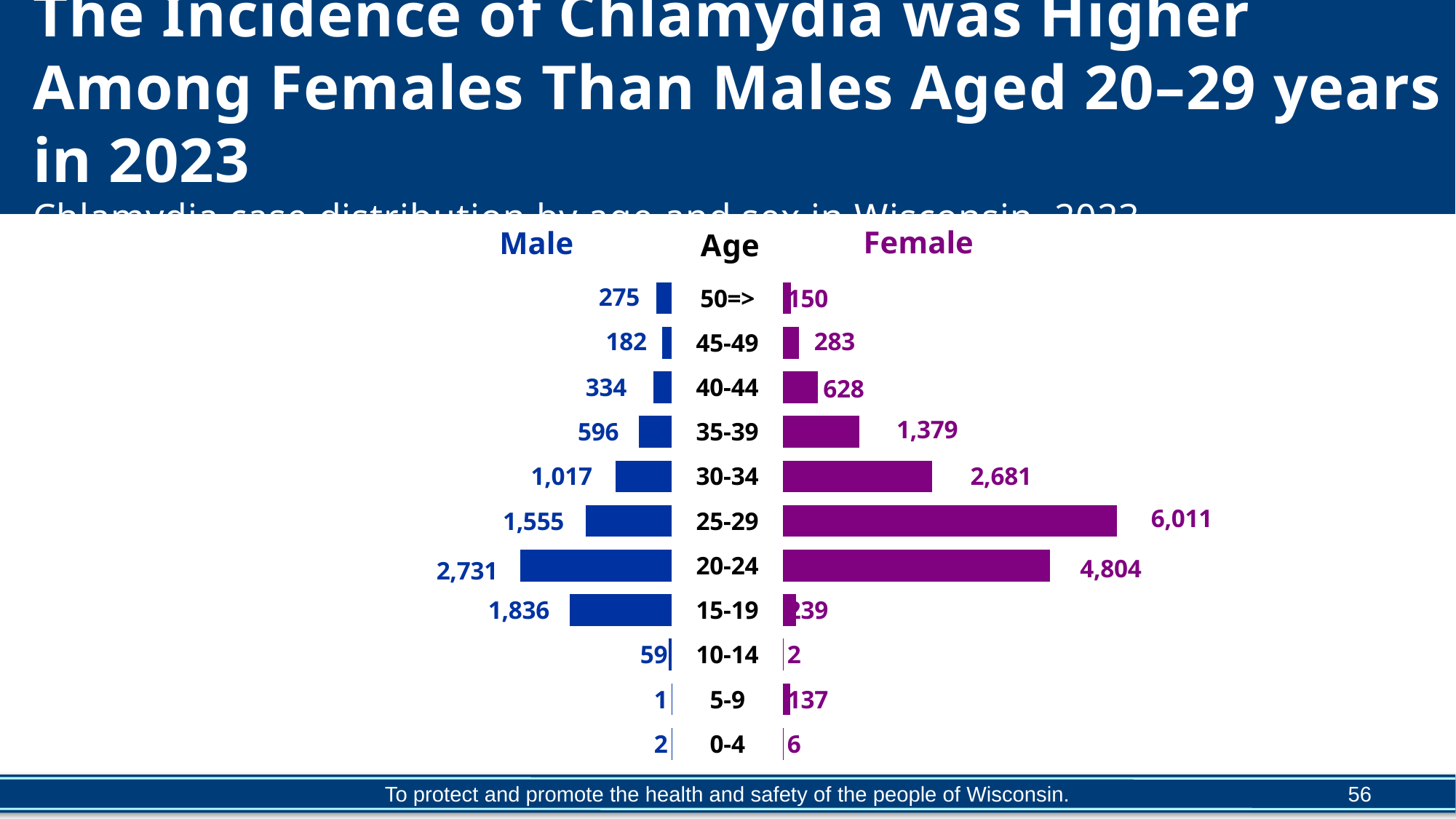
How many more female than male cases are there in the 20-24 age group? 2,073 How many series (sexes) does the chart show? 2 How many age groups are shown in the chart? 11 What is the number of female chlamydia cases in the 25-29 age group? 6,011 In the 30-34 age group, are there more male or female cases? Female Which age group has the highest number of female cases? 25-29 What is the number of male chlamydia cases in the 20-24 age group? 2,731 What type of chart is used to show the case distribution by age and sex? Bar chart What is the number of male cases in the 45-49 age group? 182 What is the number of female cases in the 35-39 age group? 1,379 What is the difference between female cases in the 25-29 and 20-24 age groups? 1,207 Which age group has the highest number of male cases? 20-24